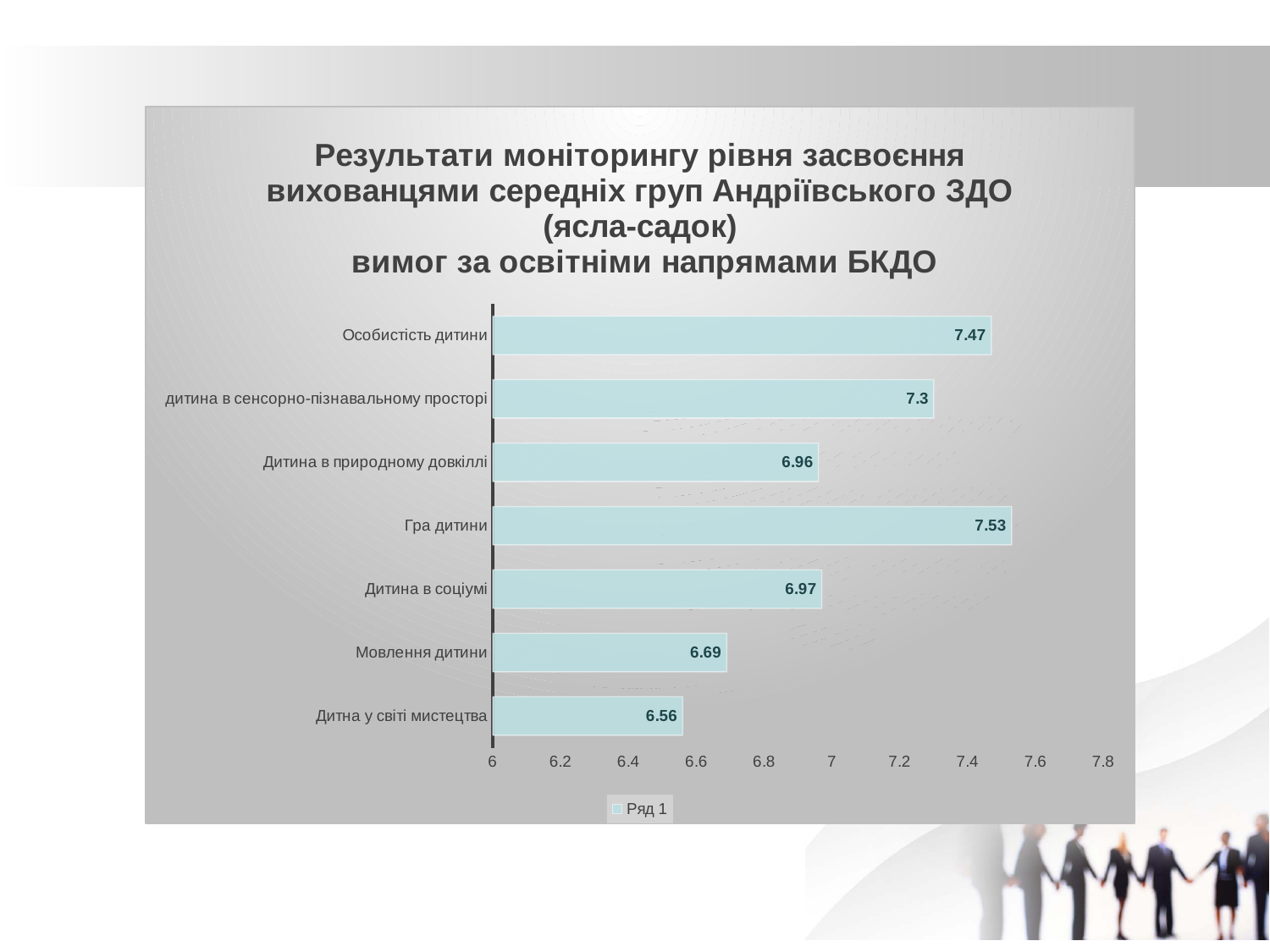
How many categories are shown in the chart? 7 Is the value for Дитина в соціумі greater or less than 7? less What kind of chart is shown on the slide? bar chart What is the legend entry shown below the chart? Ряд 1 Which category has the highest value? Гра дитини What is the value for дитина в сенсорно-пізнавальному просторі? 7.3 Which is larger, the value for Дитина в природному довкіллі or the value for Мовлення дитини? Дитина в природному довкіллі What is the value for Гра дитини? 7.53 How many series does the legend list? 1 What is the value for Мовлення дитини? 6.69 What is the difference between the values for Особистість дитини and Дитна у світі мистецтва? 0.91 Which category has the lowest value? Дитна у світі мистецтва